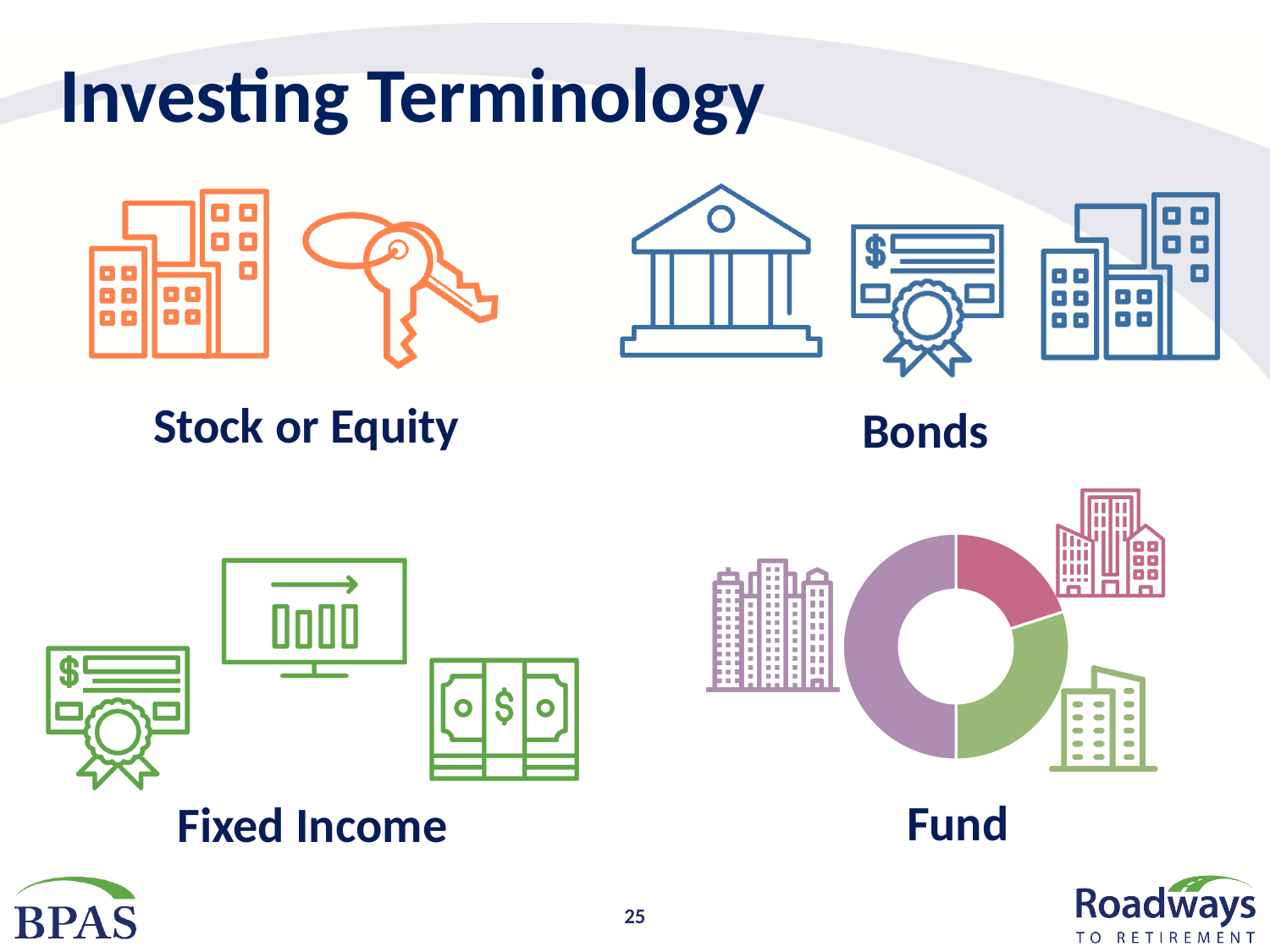
Does the doughnut chart under Fund show any data labels or values? No What kind of chart is shown in the Fund illustration? Doughnut (pie) chart How many slices does the doughnut chart under Fund have? 3 Which investing term is the doughnut chart illustrating? Fund Which colour slice takes up the largest share of the doughnut chart under Fund? Purple